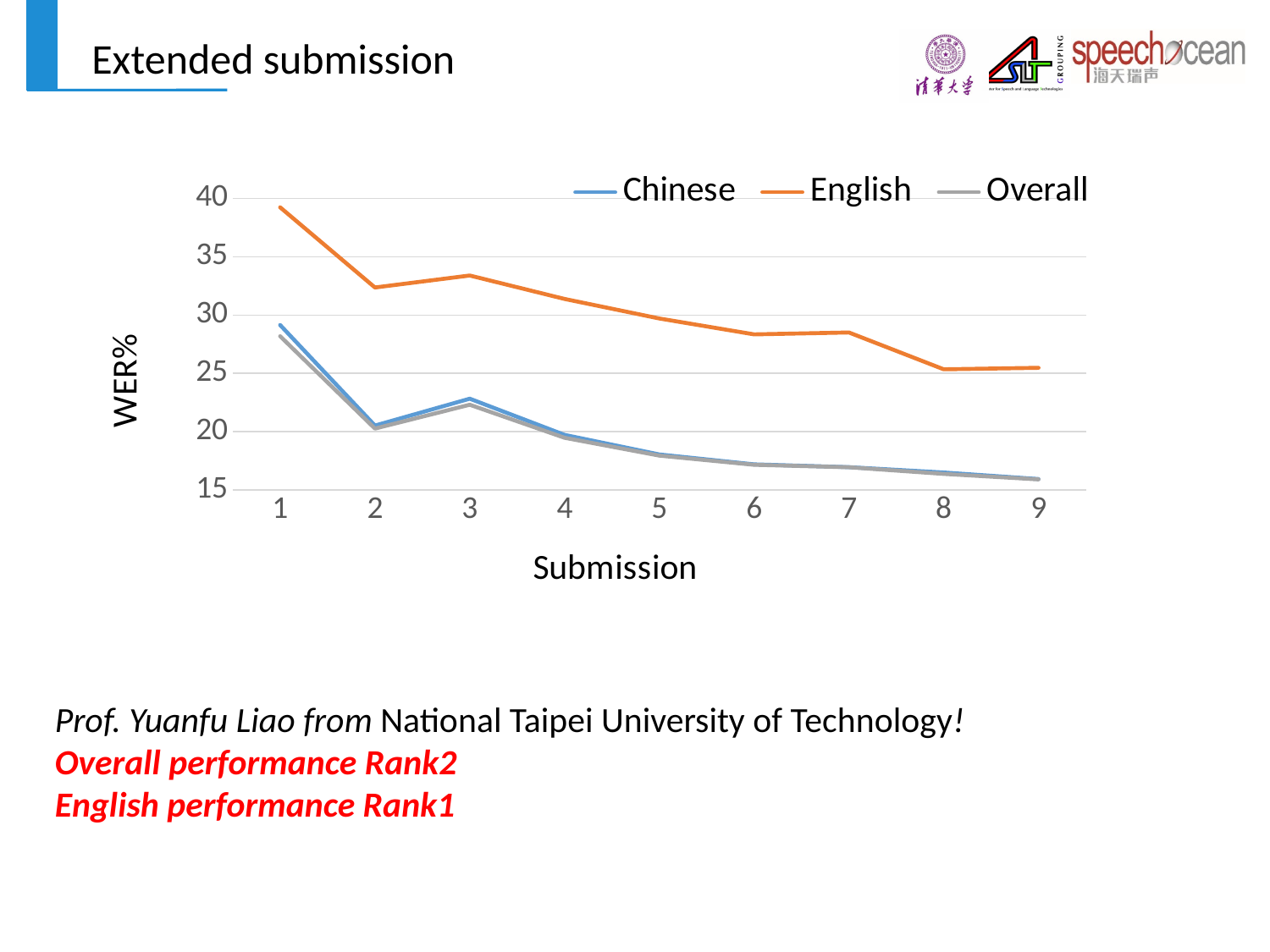
At submission 1, which series has the higher WER%, English or Chinese? English Is the Chinese value at submission 9 greater or less than 20? less What kind of chart is shown on the slide? line chart Is the English value at submission 8 greater or less than 30? less What is the label of the x axis? Submission What is the label of the y axis? WER% Is the Overall value at submission 3 greater or less than 20? greater How many submissions are plotted along the x axis? 9 Does the English WER% rise or fall overall from submission 1 to submission 9? fall How many series does the legend list? 3 At which submission is the English WER% highest? 1